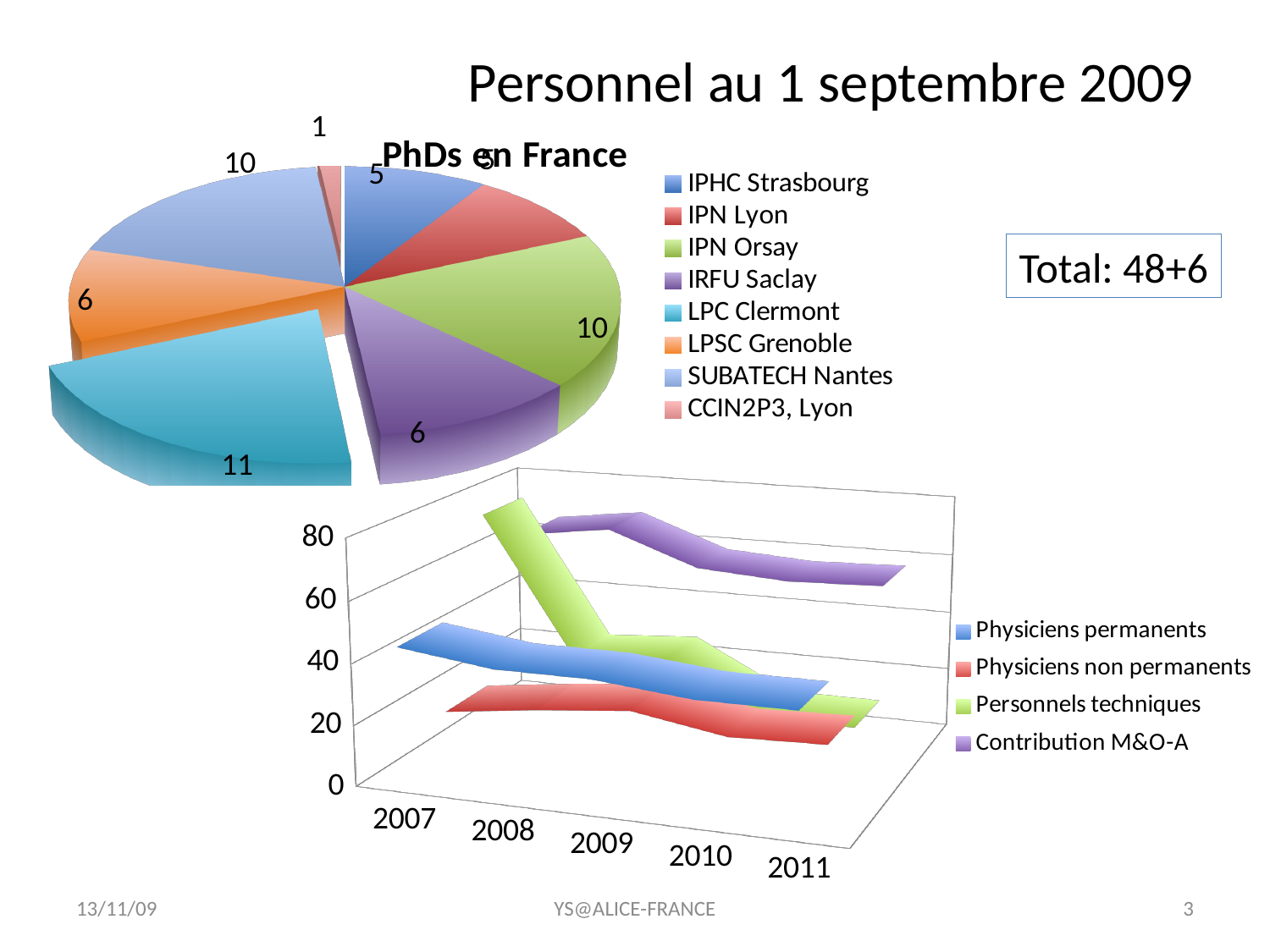
In the "PhDs en France" pie chart, what is the value for IPN Orsay? 10 In the "PhDs en France" pie chart, how many categories does the legend list? 8 In the "PhDs en France" pie chart, what is the difference between the values for LPC Clermont and IRFU Saclay? 5 In the "PhDs en France" pie chart, what is the value for LPC Clermont? 11 In the "PhDs en France" pie chart, what is the value for CCIN2P3, Lyon? 1 What kind of chart is the "PhDs en France" chart at the top of the slide? pie chart In the "PhDs en France" pie chart, which laboratory has the smallest slice? CCIN2P3, Lyon In the "PhDs en France" pie chart, which laboratory has the largest slice? LPC Clermont In the line chart at the bottom of the slide, how many years are shown on the x axis? 5 In the line chart at the bottom of the slide, how many series does the legend list? 4 In the line chart at the bottom of the slide, does the Personnels techniques series rise or fall from 2007 to 2011? fall In the "PhDs en France" pie chart, which is larger, SUBATECH Nantes or LPSC Grenoble? SUBATECH Nantes